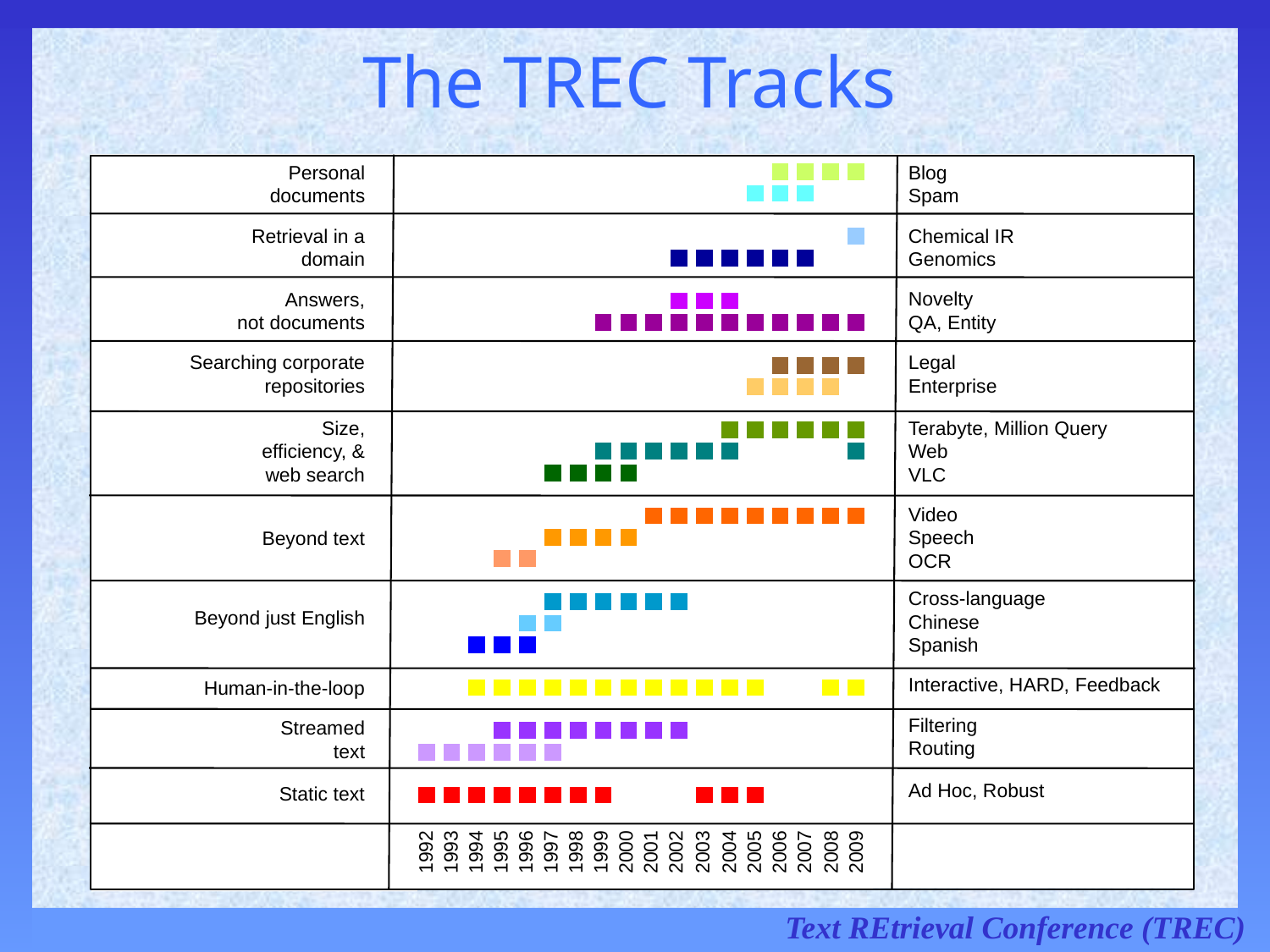
Which track category is labelled 'Ad Hoc, Robust' on the right side of the chart? Static text How many track categories (rows) does the TREC Tracks chart show? 10 In which year does the Chemical IR track (light blue square in the Retrieval in a domain row) appear? 2009 What is the earliest year shown on the x axis of the TREC Tracks chart? 1992 Which track category lists 'Blog' and 'Spam'? Personal documents In which year does the Static text track resume after its gap? 2003 How many years are listed along the x axis of the TREC Tracks chart? 18 What kind of chart is shown on the slide? timeline chart What is the title of the chart on the slide? The TREC Tracks Which track category is labelled 'Interactive, HARD, Feedback'? Human-in-the-loop What is the latest year shown on the x axis of the TREC Tracks chart? 2009 In which year does the Static text track first appear on the chart? 1992